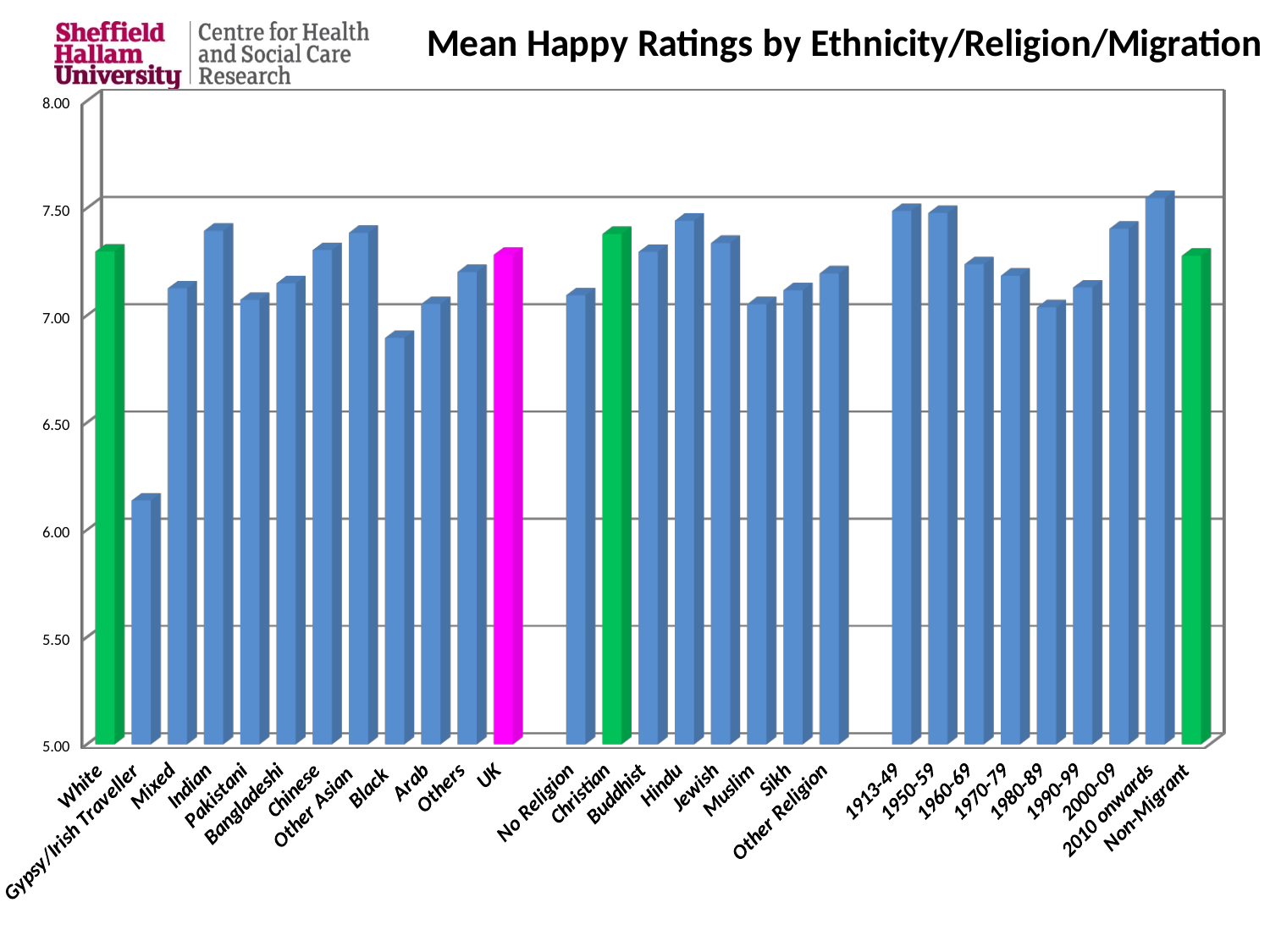
Which has the higher mean happy rating, Hindu or Muslim? Hindu Is the value for Black greater or less than 7.00? less What is the title of the chart? Mean Happy Ratings by Ethnicity/Religion/Migration Is the value for Gypsy/Irish Traveller greater or less than 6.50? less Is the value for Indian greater or less than 7.00? greater How many bars are plotted on the chart? 29 Which has the higher mean happy rating, 1913-49 or 1980-89? 1913-49 Which category has the highest mean happy rating? 2010 onwards Which category has the lowest mean happy rating? Gypsy/Irish Traveller What kind of chart is shown on the slide? Bar chart Which has the higher mean happy rating, White or Gypsy/Irish Traveller? White